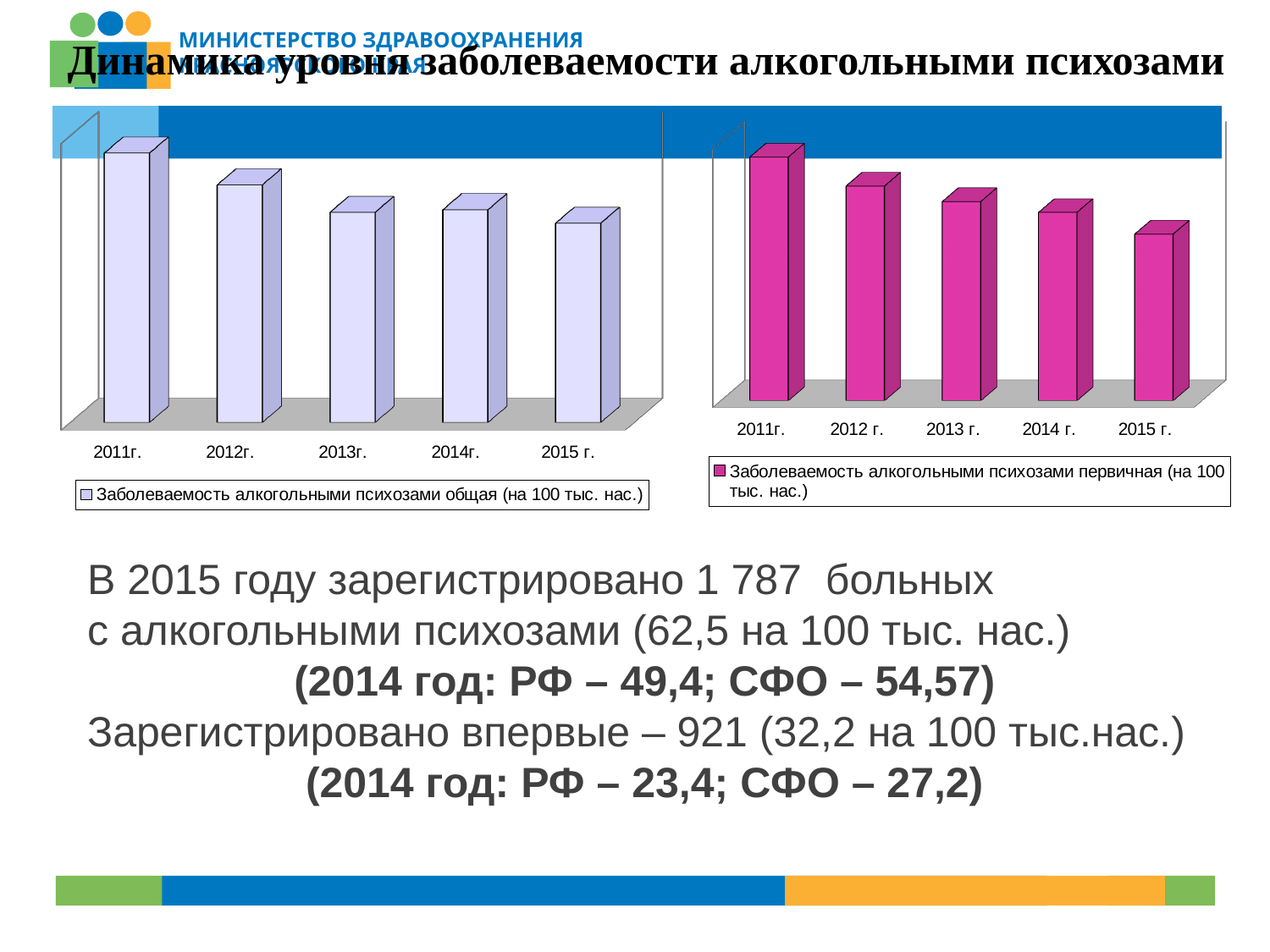
What kind of chart is the right chart? Bar chart In the left chart, which is larger: the bar for 2012г. or the bar for 2013г.? 2012г. In the right chart, which is larger: the bar for 2014 г. or the bar for 2015 г.? 2014 г. How many years are shown on the x axis of the left chart? 5 In the right chart, do the values rise or fall from 2011г. to 2015 г.? Fall In the left chart (Заболеваемость алкогольными психозами общая), which year has the lowest bar? 2015 г. In the left chart (Заболеваемость алкогольными психозами общая), which year has the highest bar? 2011г. In the right chart (Заболеваемость алкогольными психозами первичная), which year has the lowest bar? 2015 г. How many series does the legend of the left chart list? 1 What is the legend entry of the right chart? Заболеваемость алкогольными психозами первичная (на 100 тыс. нас.) In the right chart (Заболеваемость алкогольными психозами первичная), which year has the highest bar? 2011г. How many bars does the right chart contain? 5